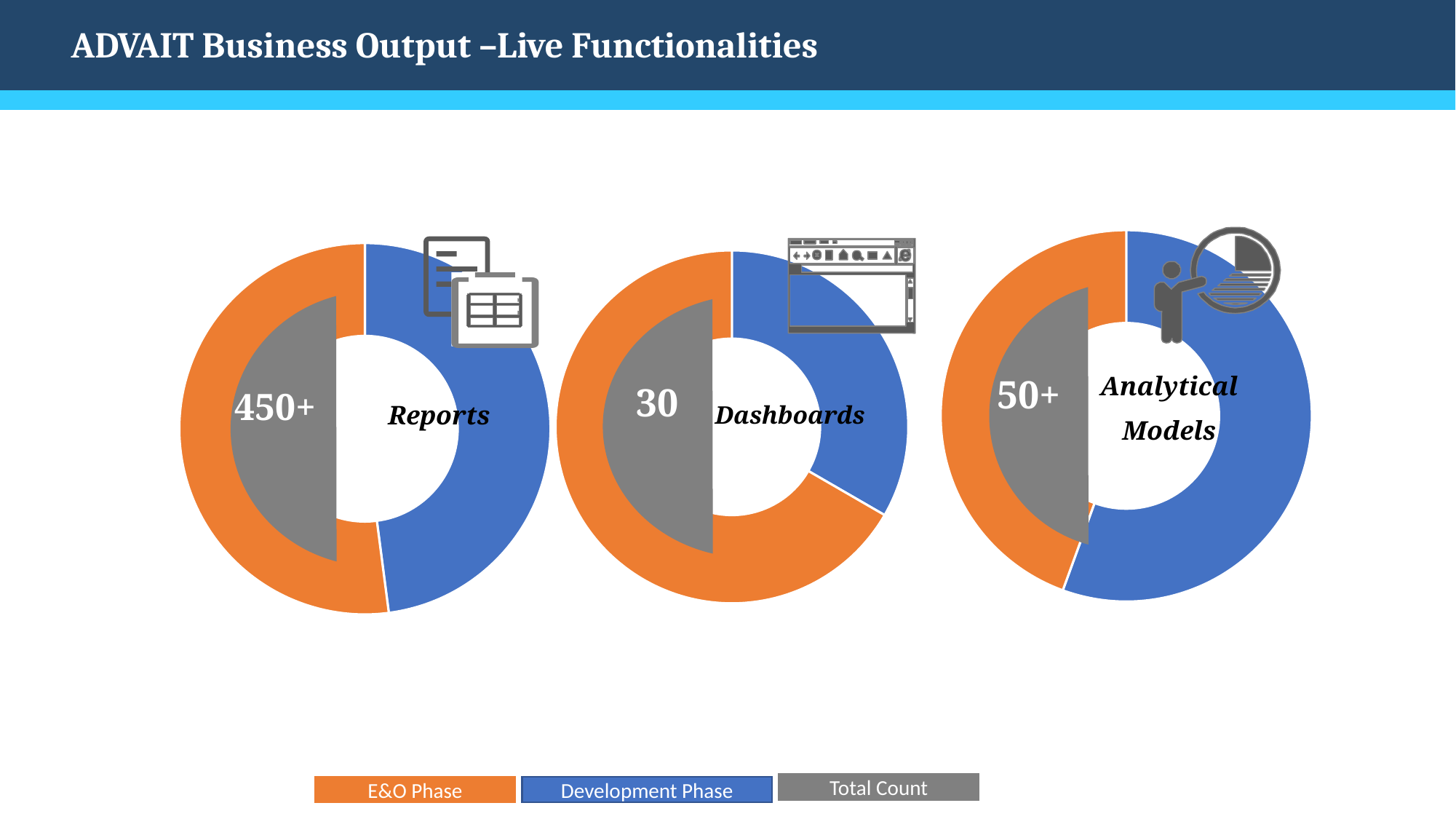
In the Analytical Models chart, which phase has the larger share: E&O Phase or Development Phase? Development Phase What is the total count shown in the Analytical Models chart? 50+ What kind of chart is used for the Reports figure on the slide? Donut (pie) chart In the Dashboards chart, which phase has the larger share: E&O Phase or Development Phase? E&O Phase Which of the three charts shows the highest total count? Reports Which legend entry is shown in grey? Total Count What is the total count shown in the Dashboards chart? 30 Which colour represents the E&O Phase in the legend? Orange Which of the three charts shows the lowest total count? Dashboards How many entries does the legend at the bottom of the slide list? 3 How many donut charts are shown on the slide? 3 What is the total count shown in the Reports chart? 450+